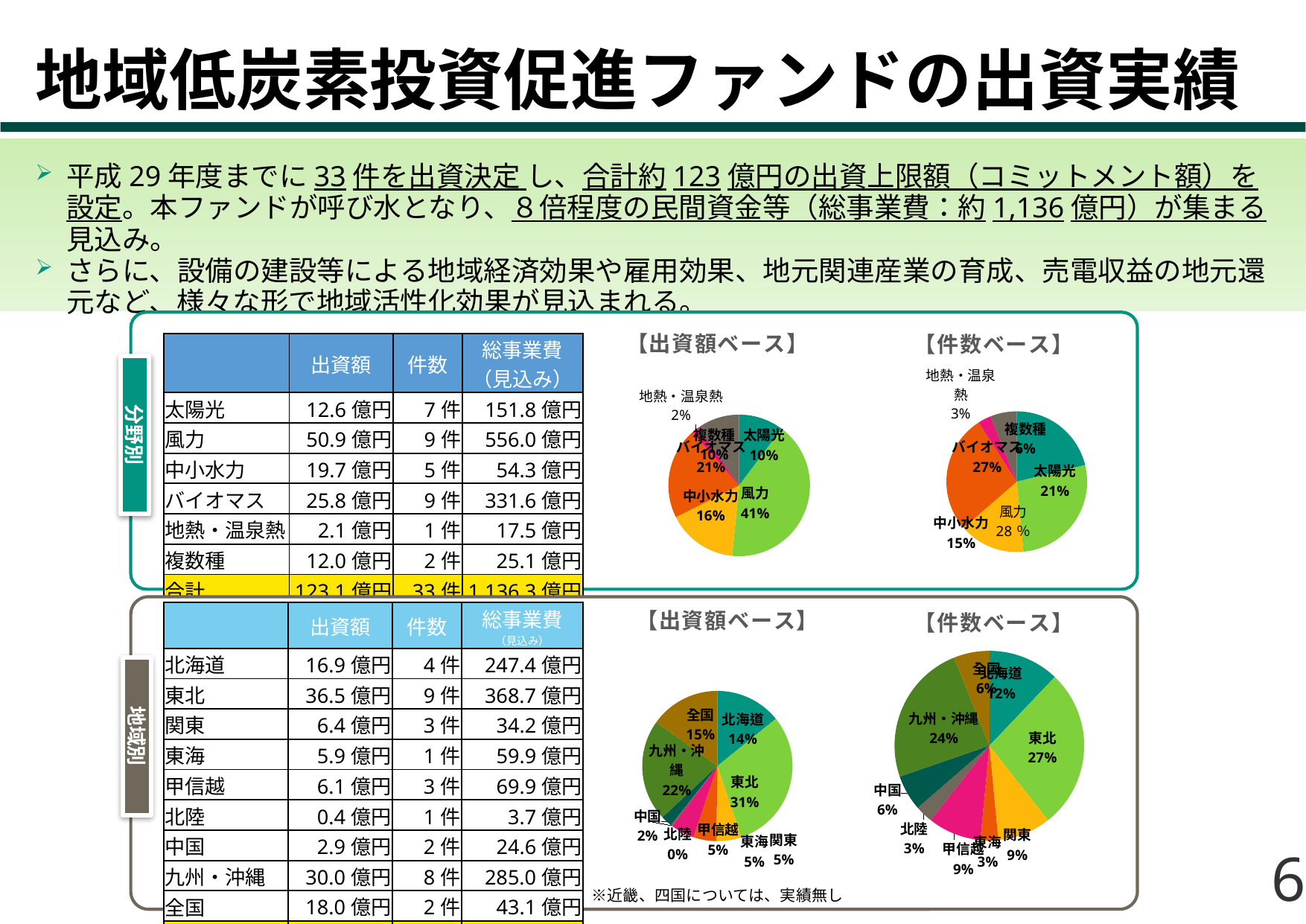
What type of chart is used for the 【件数ベース】 chart in the bottom-right of the slide? Pie chart In the bottom-left pie chart (地域別 【出資額ベース】), which region has the largest share? 東北 In the top-right pie chart (分野別 【件数ベース】), what is the difference between the shares of 風力 and 太陽光? 7% In the top-right pie chart (分野別 【件数ベース】), what share does バイオマス have? 27% In the top-left pie chart (分野別 【出資額ベース】), which category has the smallest share? 地熱・温泉熱 In the bottom-right pie chart (地域別 【件数ベース】), what is the difference between the shares of 東北 and 九州・沖縄? 3% In the bottom-left pie chart (地域別 【出資額ベース】), what share does 東北 have? 31% In the bottom-right pie chart (地域別 【件数ベース】), what share does 北海道 have? 12% In the top-left pie chart (分野別 【出資額ベース】), which category has the largest share? 風力 In the top-right pie chart (分野別 【件数ベース】), which is larger, the share of 中小水力 or the share of 複数種? 中小水力